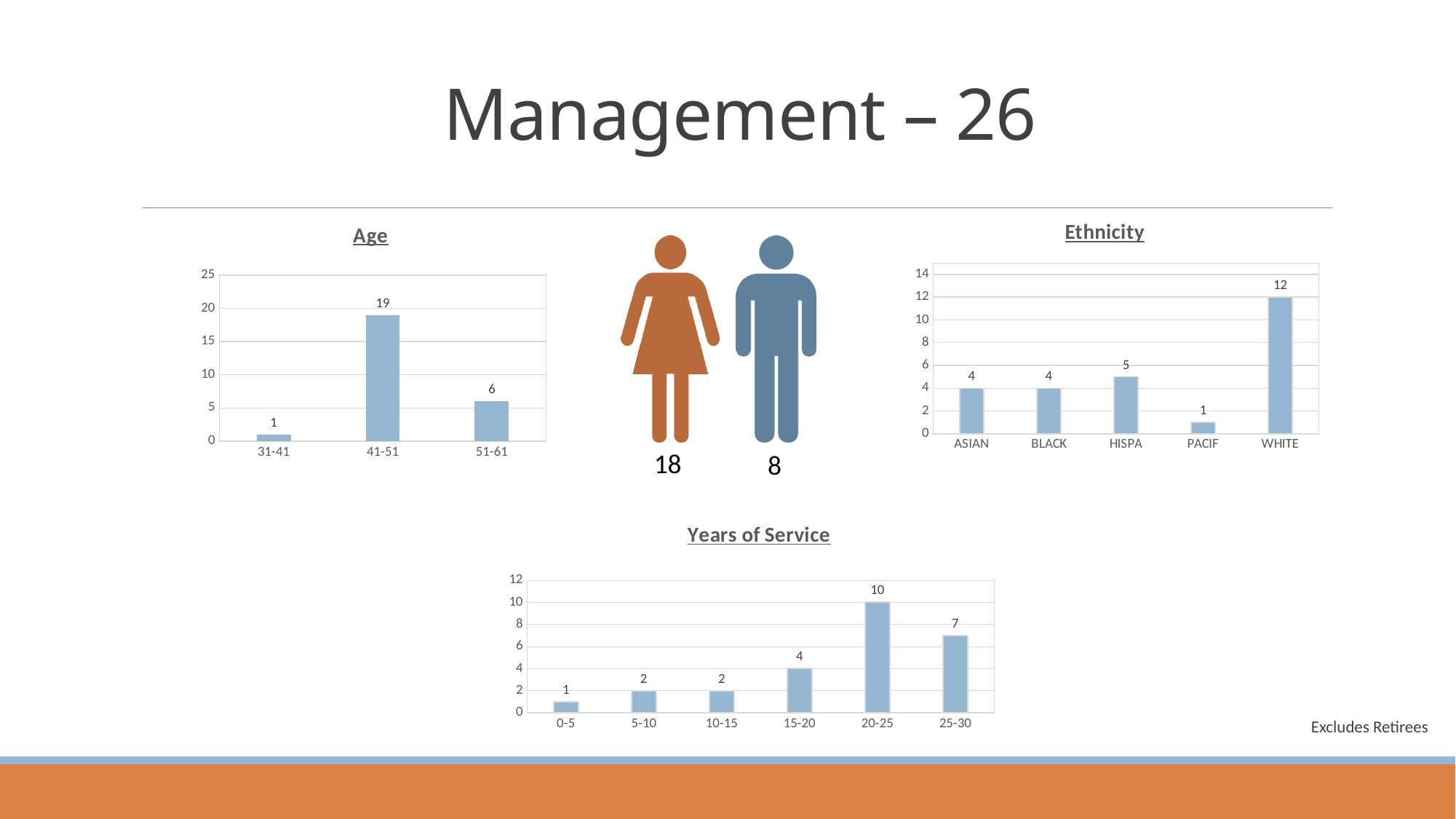
In the Age chart, what is the value for the 41-51 category? 19 What is the title of the chart in the top-left of the slide? Age In the Years of Service chart, which is larger, the value for 15-20 or the value for 25-30? 25-30 In the Years of Service chart, how many categories are shown on the x axis? 6 What kind of chart is the Years of Service chart? Bar chart In the Ethnicity chart, which category has the highest value? WHITE In the Ethnicity chart, how many categories are shown on the x axis? 5 In the Age chart, which age category has the lowest value? 31-41 In the Ethnicity chart, what is the value for HISPA? 5 In the Years of Service chart, what is the value for 20-25? 10 In the Age chart, what is the difference between the 41-51 and 51-61 values? 13 In the Ethnicity chart, what is the difference between the WHITE and PACIF values? 11